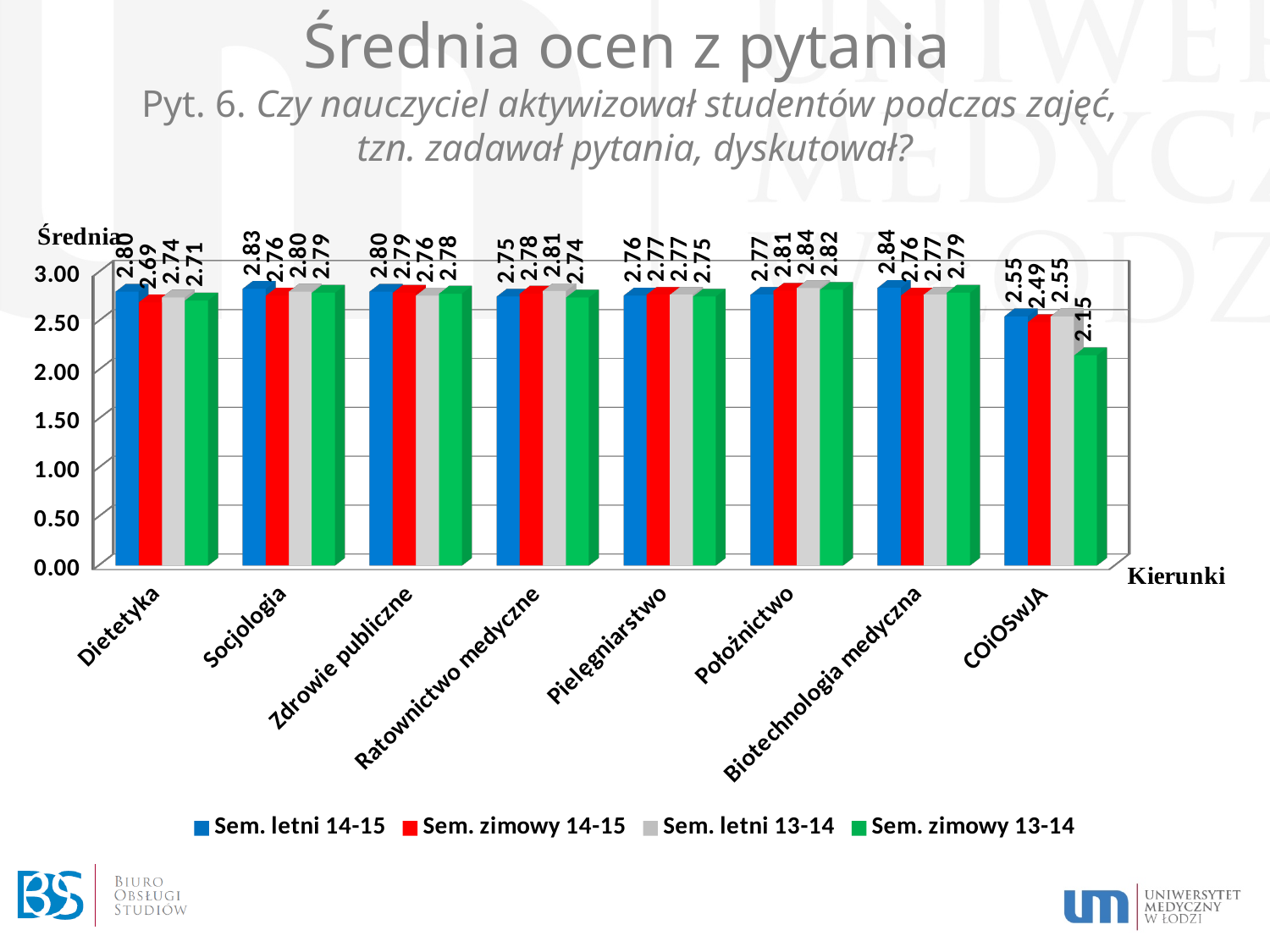
Which is larger for Dietetyka: the Sem. letni 14-15 value or the Sem. zimowy 14-15 value? Sem. letni 14-15 Which category has the highest value in the Sem. letni 14-15 series? Biotechnologia medyczna What kind of chart is shown on the slide? bar chart How many categories (kierunki) are shown on the x axis? 8 How many series does the legend list? 4 What is the value for Położnictwo in the Sem. letni 13-14 series? 2.84 What is the value for Ratownictwo medyczne in the Sem. zimowy 14-15 series? 2.78 What is the value for Dietetyka in the Sem. letni 14-15 series? 2.80 What is the difference between the Sem. letni 14-15 value and the Sem. zimowy 13-14 value for COiOSwJA? 0.40 Which category has the lowest value in the Sem. zimowy 13-14 series? COiOSwJA What is the value for COiOSwJA in the Sem. zimowy 13-14 series? 2.15 Is the Sem. zimowy 13-14 value for COiOSwJA greater or less than 2.50? less